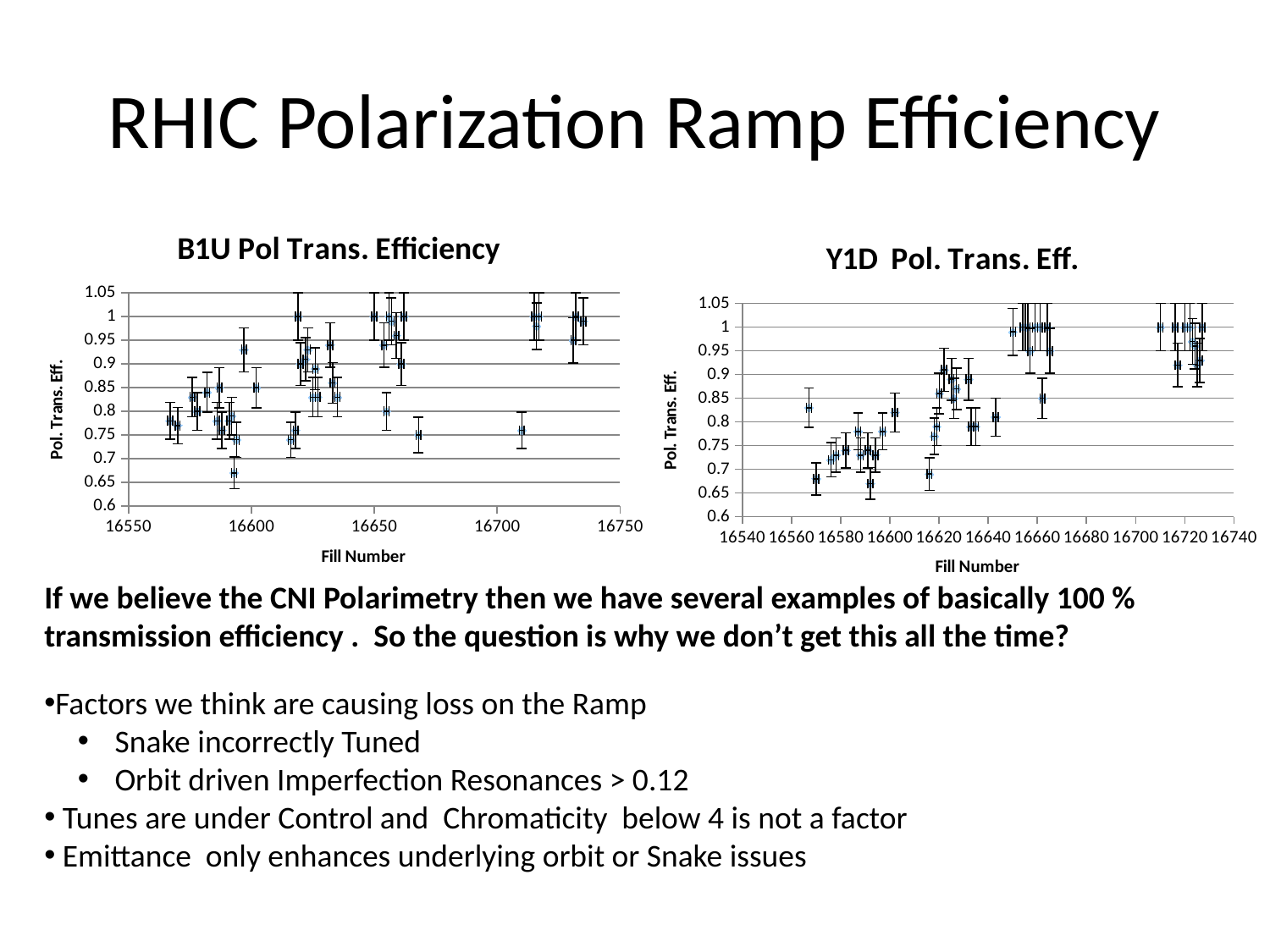
In the Y1D Pol. Trans. Eff. chart, do the plotted values generally rise or fall as the fill number increases? rise In the B1U Pol Trans. Efficiency chart, is the highest plotted value greater or less than 0.95? greater In the Y1D Pol. Trans. Eff. chart, is the lowest plotted value greater or less than 0.75? less What kind of chart is the B1U Pol Trans. Efficiency chart? scatter chart In the Y1D Pol. Trans. Eff. chart, are the points near fill number 16710 greater or less than 0.95? greater What kind of chart is the Y1D Pol. Trans. Eff. chart? scatter chart What is the x-axis label of the Y1D Pol. Trans. Eff. chart? Fill Number In the B1U Pol Trans. Efficiency chart, do the plotted values generally rise or fall as the fill number increases? rise What is the title of the chart on the left of the slide? B1U Pol Trans. Efficiency